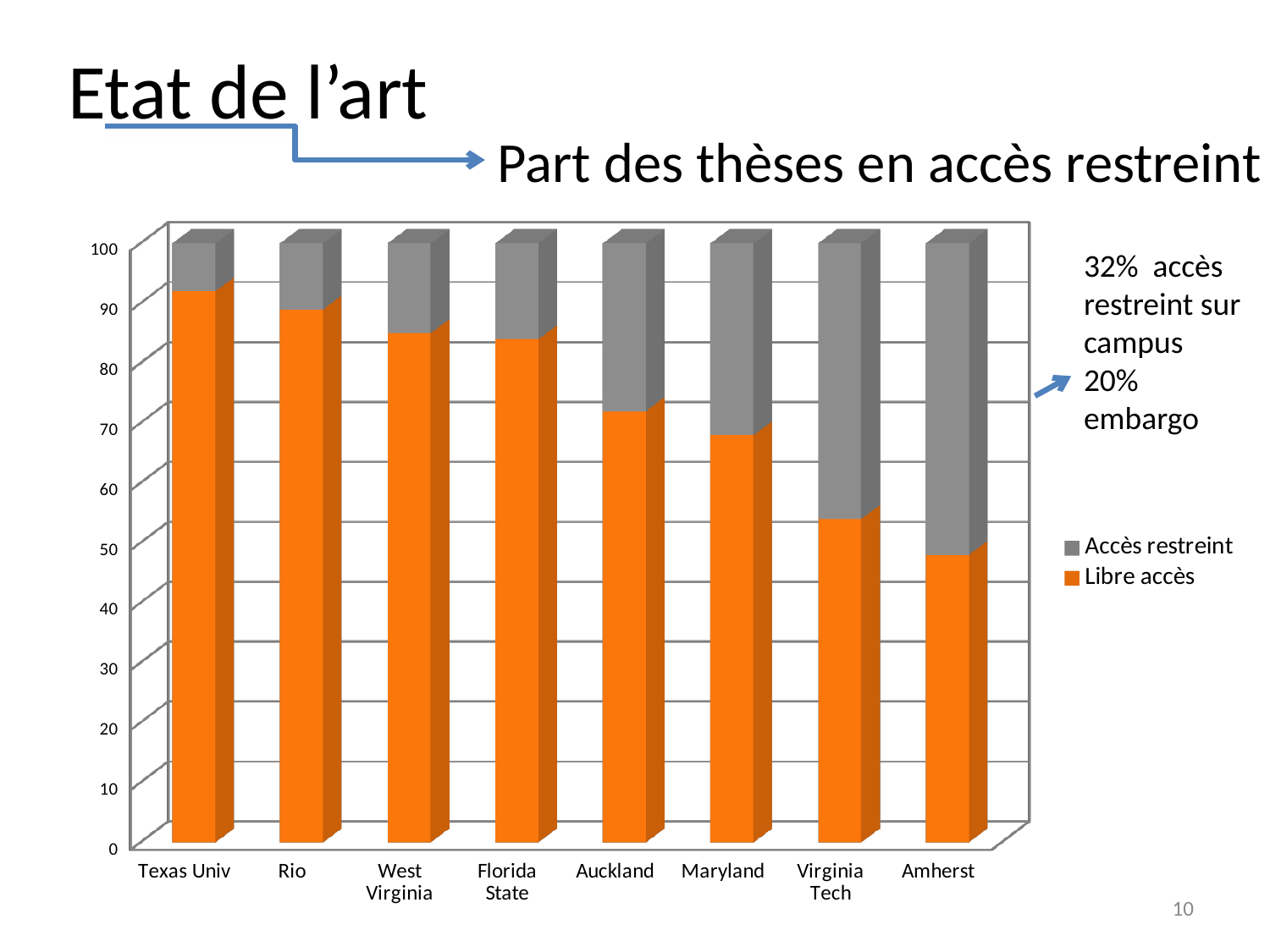
Does the Libre accès share rise or fall moving from Texas Univ to Amherst along the x axis? Fall Is the Libre accès value for Virginia Tech greater or less than 60? less Which university has the largest Accès restreint segment? Amherst How many series does the chart legend list? 2 How many universities are shown on the x axis of the chart? 8 Is the Libre accès value for Texas Univ greater or less than 80? greater Is the Libre accès value for Auckland greater or less than 80? less Which colour represents Accès restreint in the chart? Gray Which university has the highest share of Libre accès? Texas Univ What kind of chart is shown on the slide? Stacked bar chart Which has a larger Libre accès share, Rio or Maryland? Rio Which university has the lowest share of Libre accès? Amherst